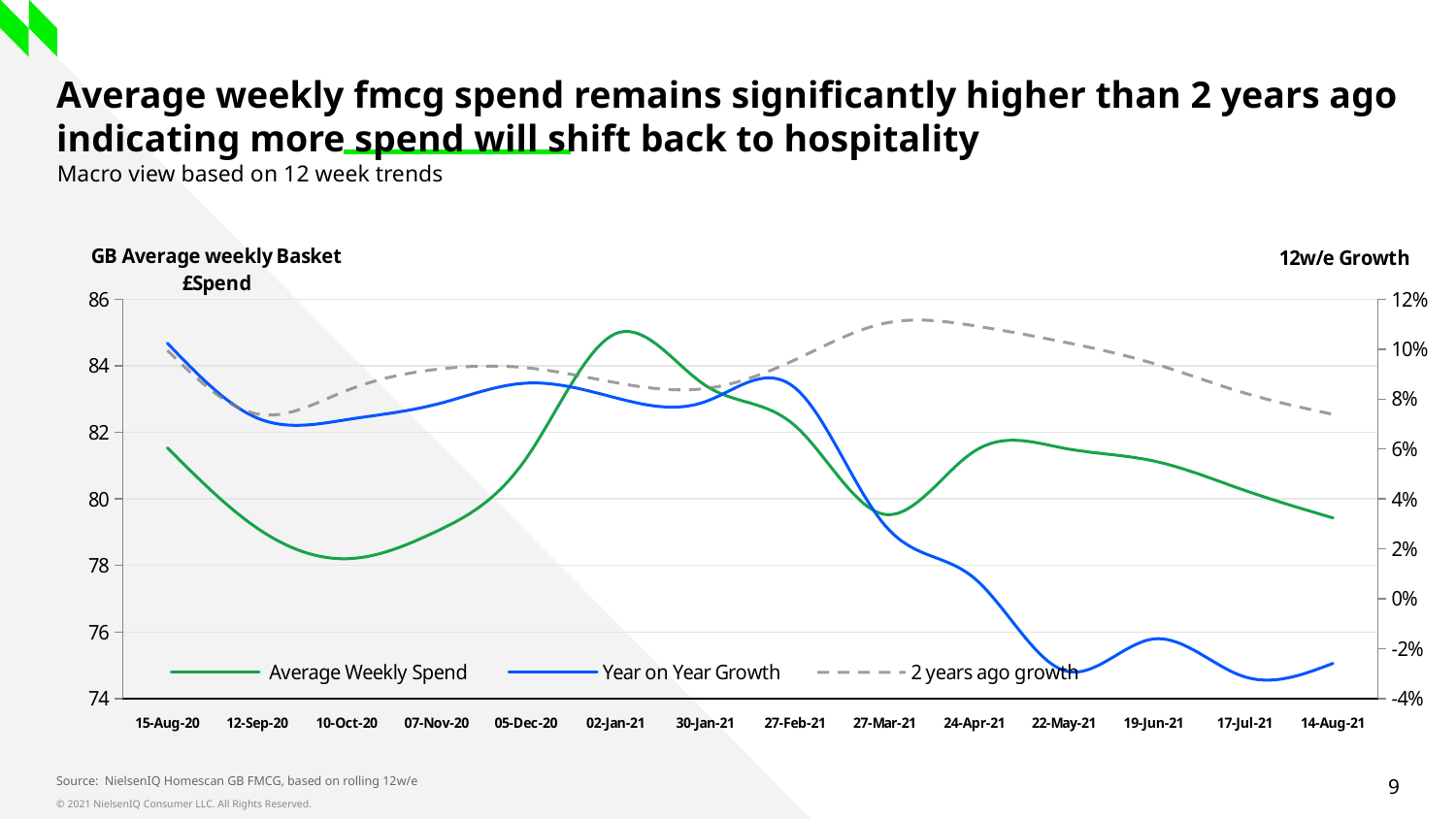
At 14-Aug-21, which is higher: Year on Year Growth or 2 years ago growth? 2 years ago growth At which date does the Average Weekly Spend line reach its lowest point? 10-Oct-20 Is the 2 years ago growth value at 27-Mar-21 greater or less than 10%? greater Does the Average Weekly Spend line rise or fall between 24-Apr-21 and 14-Aug-21? fall What type of chart is shown on the slide? Line chart What is the title of the left-hand vertical axis of the chart? GB Average weekly Basket £Spend Is the Average Weekly Spend value at 02-Jan-21 greater or less than 84? greater How many dates are labelled along the x axis of the chart? 14 Is the Year on Year Growth value at 14-Aug-21 greater or less than 0%? less How many series does the chart legend list? 3 Does the Year on Year Growth line rise or fall between 27-Feb-21 and 22-May-21? fall At which date does the Average Weekly Spend line reach its highest point? 02-Jan-21